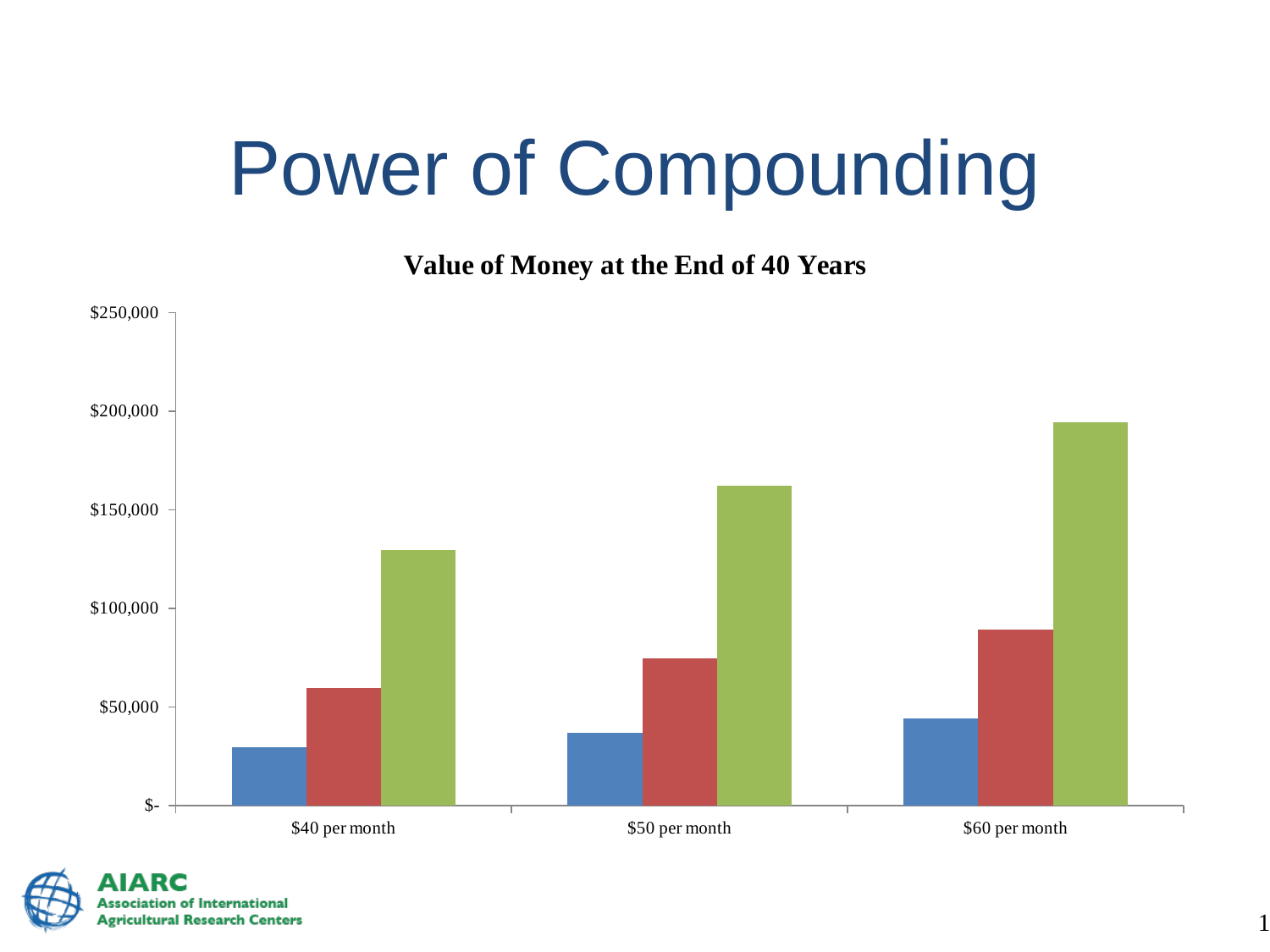
Which is larger: the green bar for $40 per month or the green bar for $60 per month? $60 per month Which category has the tallest bar in the chart? $60 per month Is the value of the red bar for $60 per month greater or less than $100,000? less Is the value of the blue bar for $40 per month greater or less than $50,000? less How many bars are plotted for each category in the chart? 3 Do the values of the green bars rise or fall from $40 per month to $60 per month? rise Is the value of the red bar for $50 per month greater or less than $50,000? greater How many categories are shown on the x axis of the chart? 3 What kind of chart is shown on the slide? bar chart What is the title of the chart? Value of Money at the End of 40 Years